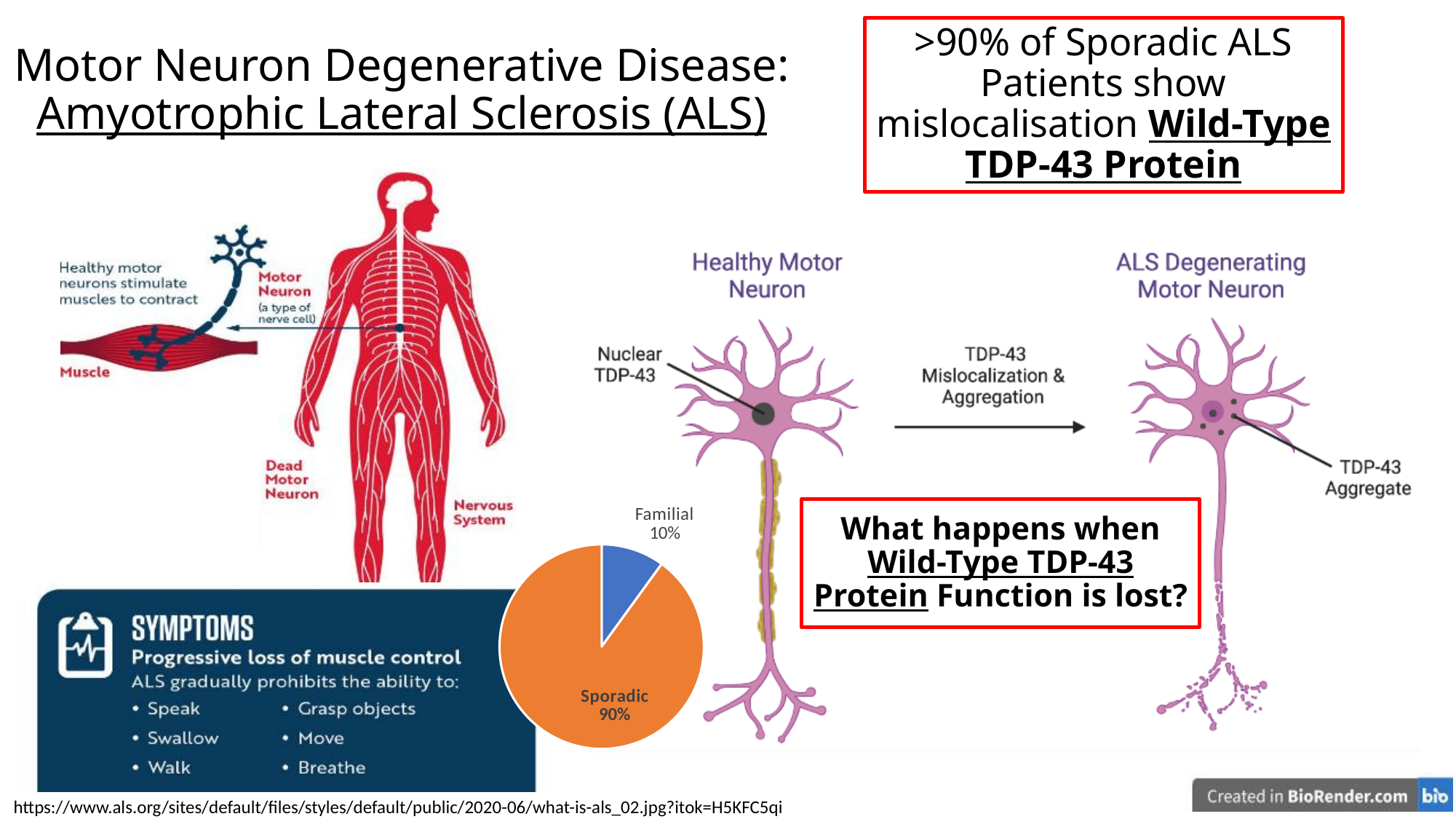
Which slice of the pie chart is the largest? Sporadic What kind of chart is shown on the slide? pie chart What colour is the Familial slice of the pie chart? blue What is the total of the two slices shown in the pie chart? 100% What is the difference between the Sporadic and Familial shares in the pie chart? 80% Which slice of the pie chart is the smallest? Familial What colour is the Sporadic slice of the pie chart? orange What share of the pie chart is labelled Sporadic? 90% What share of the pie chart is labelled Familial? 10% How many slices does the pie chart have? 2 Which is larger in the pie chart, Sporadic or Familial? Sporadic